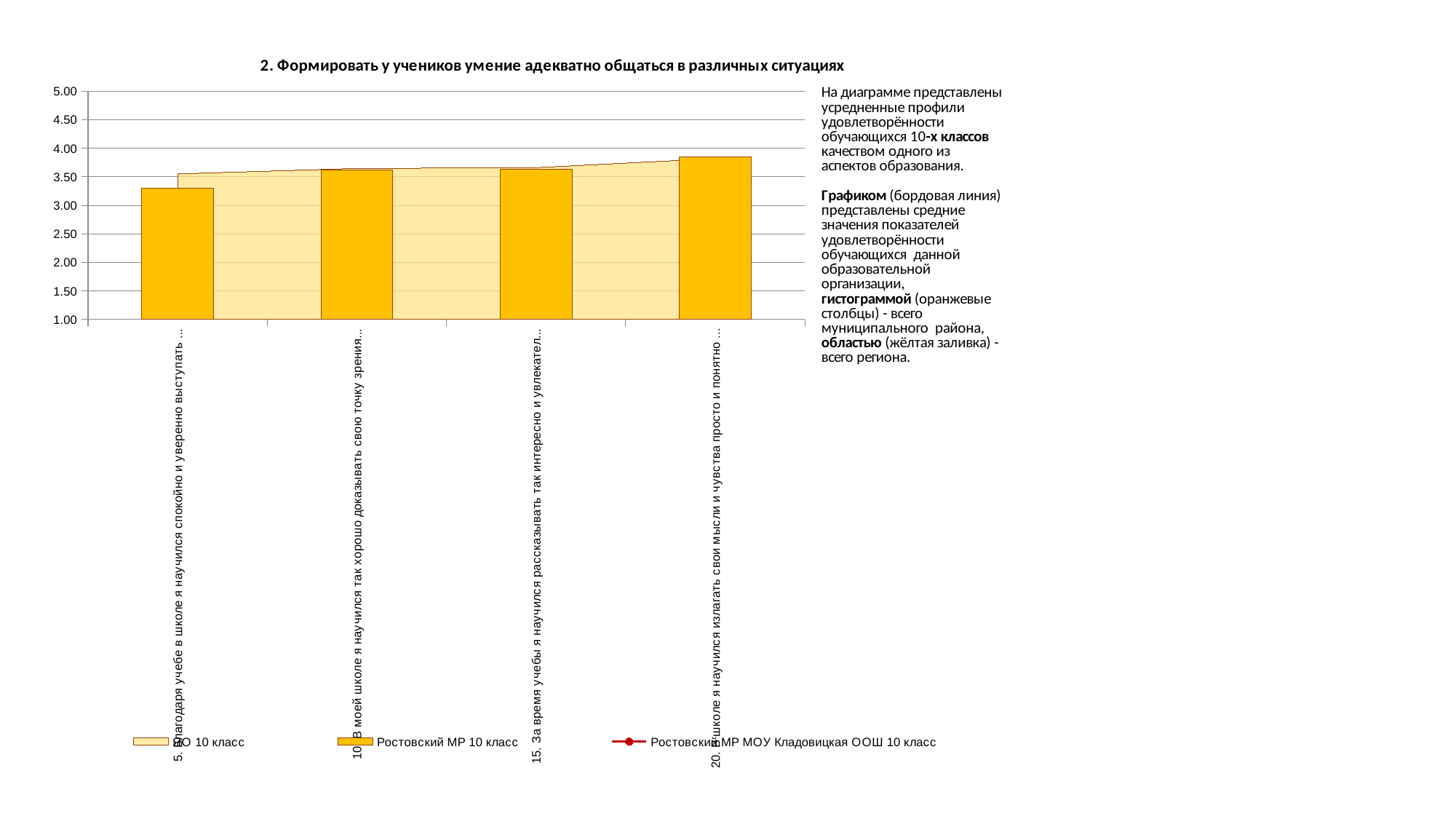
How many categories are plotted along the x axis? 4 What is the title of the chart? 2. Формировать у учеников умение адекватно общаться в различных ситуациях Is the orange bar for category 20 (В школе я научился излагать свои мысли и чувства просто и понятно) greater or less than 3.50? greater Which series in the legend is shown as a red line with markers? Ростовский МР МОУ Кладовицкая ООШ 10 класс Which is larger for the series 'Ростовский МР 10 класс': the bar for category 5 or the bar for category 20? category 20 What kind of chart is used for the series 'Ростовский МР 10 класс'? bar chart Which category has the lowest orange bar (Ростовский МР 10 класс)? 5. Благодаря учебе в школе я научился спокойно и уверенно выступать Which category has the highest orange bar (Ростовский МР 10 класс)? 20. В школе я научился излагать свои мысли и чувства просто и понятно Is the orange bar for category 5 (Благодаря учебе в школе я научился спокойно и уверенно выступать) greater or less than 3.50? less How many series does the chart legend list? 3 Is the orange bar for category 20 (В школе я научился излагать свои мысли и чувства просто и понятно) greater or less than 4.00? less Do the orange bars (Ростовский МР 10 класс) generally rise or fall from left to right along the x axis? rise